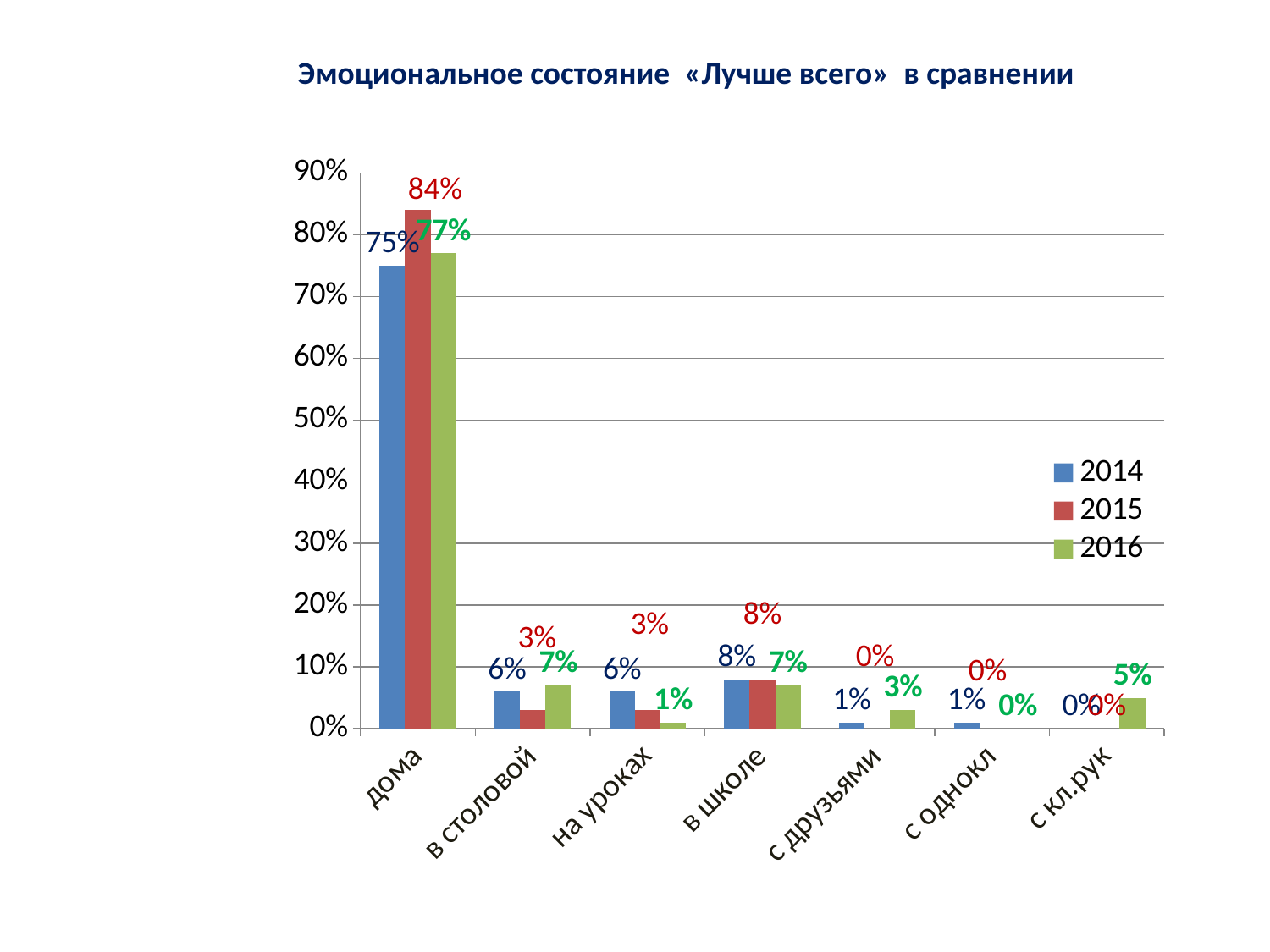
What is the value for 2015 in the category «дома»? 84% What kind of chart is shown on the slide? bar chart What is the difference between the 2015 and 2014 values in the category «дома»? 9% Which is larger in the category «на уроках»: the 2015 value or the 2016 value? 2015 Which category has the highest value for the 2014 series? дома What is the value for 2016 in the category «с кл.рук»? 5% What is the value for 2016 in the category «в столовой»? 7% What is the value for 2014 in the category «на уроках»? 6% How many categories are shown on the x axis? 7 How many series does the legend list? 3 What is the title of the chart? Эмоциональное состояние «Лучше всего» в сравнении Which category has the lowest value for the 2016 series? с однокл